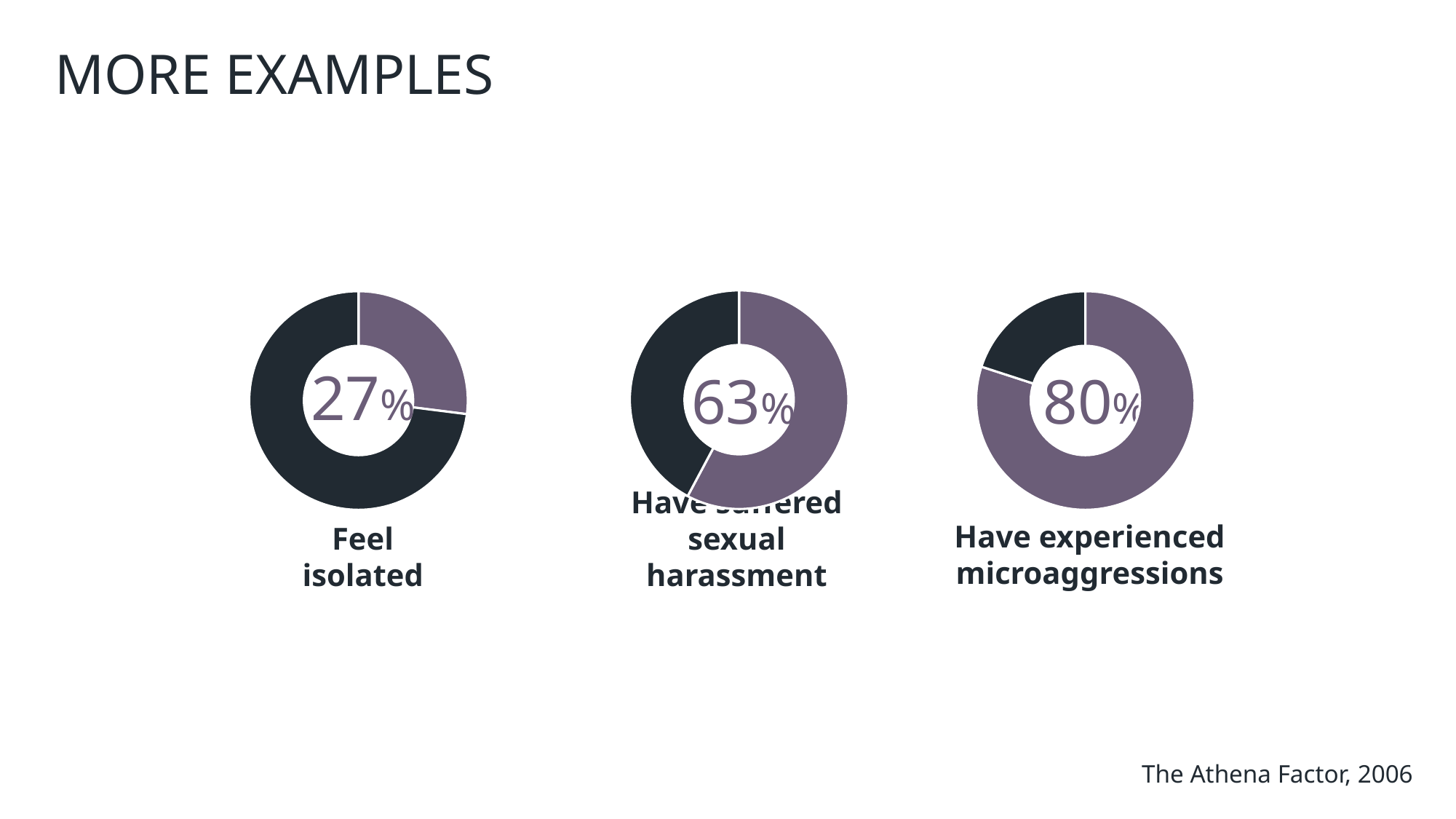
How many donut charts are shown on the slide? 3 What percentage is shown in the 'Have suffered sexual harassment' donut chart? 63% What is the difference between the percentage in the 'Have suffered sexual harassment' chart and the 'Feel isolated' chart? 36% What is the difference between the percentage in the 'Have experienced microaggressions' chart and the 'Feel isolated' chart? 53% What source is cited for the charts on the slide? The Athena Factor, 2006 Which is larger: the percentage in the 'Have suffered sexual harassment' chart or the 'Feel isolated' chart? Have suffered sexual harassment Across the three donut charts, which category has the highest percentage? Have experienced microaggressions In the 'Feel isolated' donut chart, what share of the ring is the purple slice? 27% Across the three donut charts, which category has the lowest percentage? Feel isolated What percentage is shown in the 'Have experienced microaggressions' donut chart? 80% What percentage is shown in the 'Feel isolated' donut chart? 27% What kind of chart is used for the 'Feel isolated' statistic? Donut chart